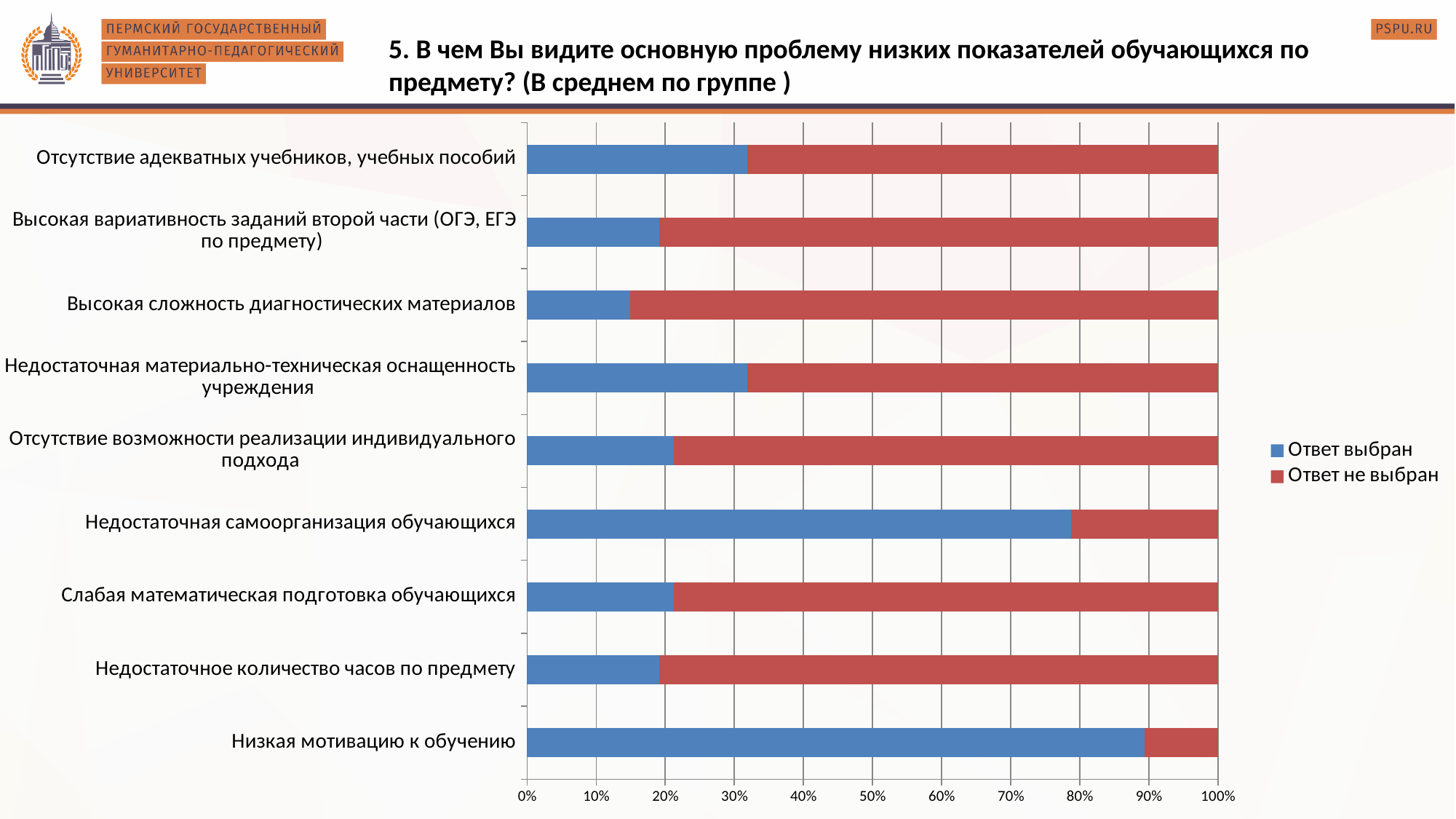
How many series does the legend list? 2 Is the "Ответ выбран" share for "Недостаточная самоорганизация обучающихся" greater or less than 70%? greater Is the "Ответ выбран" share for "Высокая сложность диагностических материалов" greater or less than 20%? less What is the total of the stacked bar for "Низкая мотивацию к обучению"? 100% What are the two series named in the legend? Ответ выбран; Ответ не выбран Which category has the highest share of "Ответ выбран"? Низкая мотивацию к обучению Is the "Ответ выбран" share for "Низкая мотивацию к обучению" greater or less than 80%? greater Which has a larger "Ответ выбран" share: "Недостаточная самоорганизация обучающихся" or "Слабая математическая подготовка обучающихся"? Недостаточная самоорганизация обучающихся What kind of chart is shown on the slide? Stacked bar chart Which category has the lowest share of "Ответ выбран"? Высокая сложность диагностических материалов How many categories (problems) are listed on the chart? 9